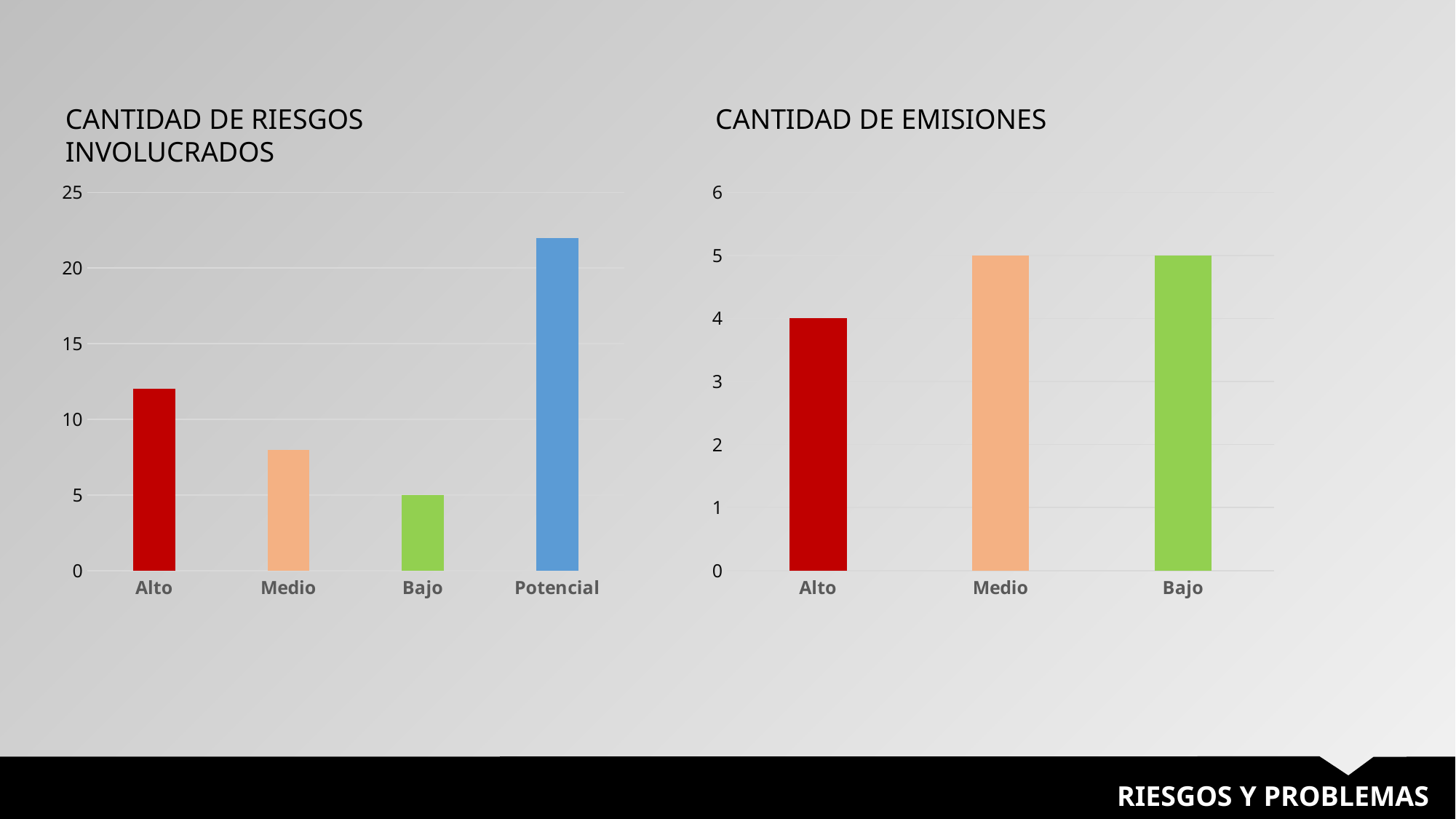
In the CANTIDAD DE EMISIONES chart, what is the value for Alto? 4 In the CANTIDAD DE RIESGOS INVOLUCRADOS chart, is the value for Potencial greater or less than 20? greater In the CANTIDAD DE EMISIONES chart, what is the value for Medio? 5 In the CANTIDAD DE RIESGOS INVOLUCRADOS chart, which category has the highest value? Potencial In the CANTIDAD DE EMISIONES chart, which category has the lowest value? Alto How many categories are shown in the CANTIDAD DE RIESGOS INVOLUCRADOS chart? 4 In the CANTIDAD DE RIESGOS INVOLUCRADOS chart, what is the value for Bajo? 5 In the CANTIDAD DE RIESGOS INVOLUCRADOS chart, which is larger, Alto or Medio? Alto What type of chart is the CANTIDAD DE EMISIONES chart? bar chart In the CANTIDAD DE RIESGOS INVOLUCRADOS chart, is the value for Alto greater or less than 10? greater In the CANTIDAD DE RIESGOS INVOLUCRADOS chart, which category has the lowest value? Bajo In the CANTIDAD DE EMISIONES chart, what is the difference between the values for Medio and Alto? 1